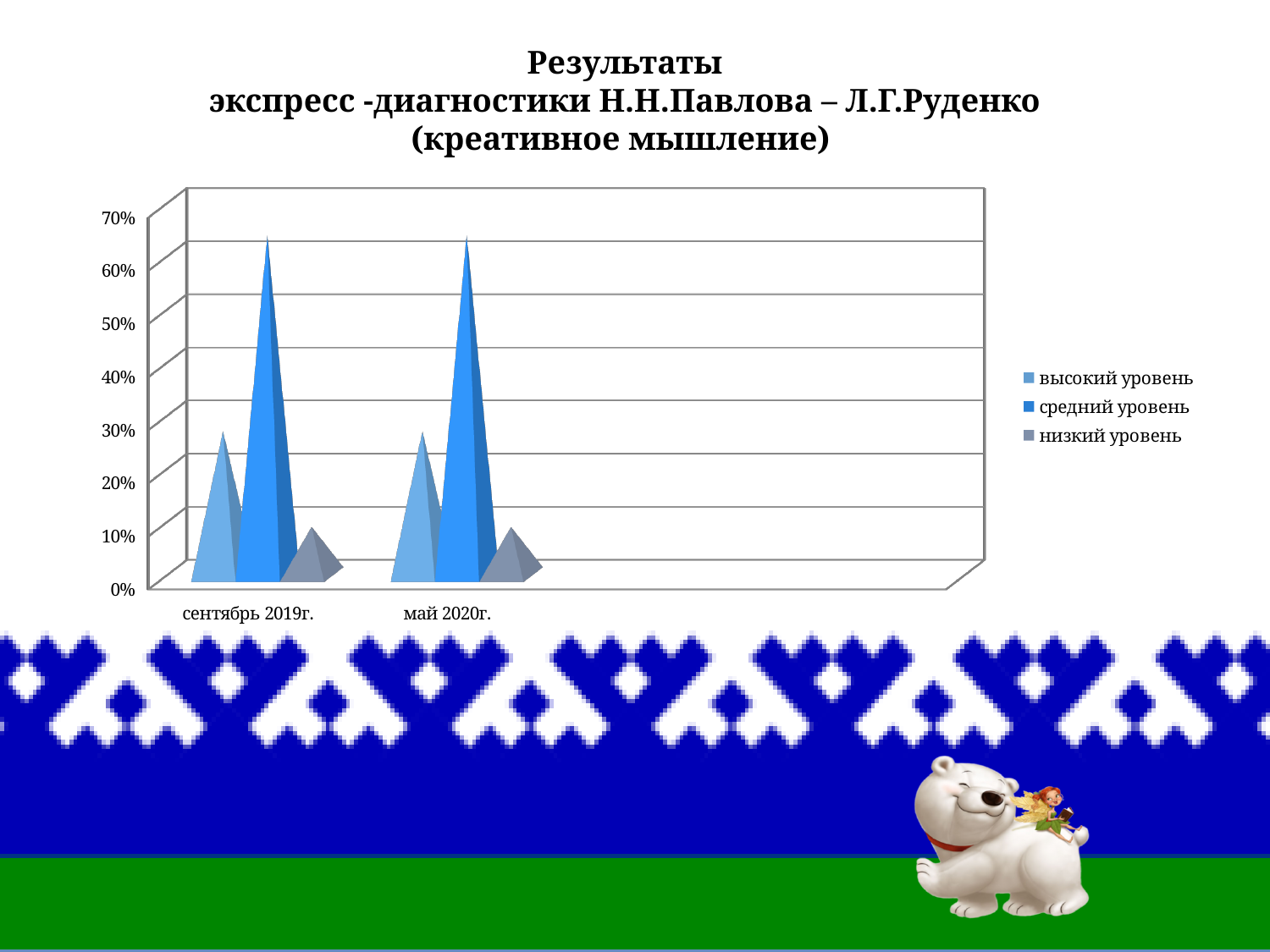
Which series has the highest value for сентябрь 2019г.? средний уровень Is the value for низкий уровень in май 2020г. greater or less than 20%? less What kind of chart is shown on the slide? bar chart Is the value for высокий уровень in сентябрь 2019г. greater or less than 40%? less Is the value for средний уровень in май 2020г. greater or less than 70%? less Which series has the lowest value for май 2020г.? низкий уровень How many series does the legend list? 3 Which series has the highest value for май 2020г.? средний уровень How many categories are shown on the x axis? 2 For май 2020г., which is larger: высокий уровень or средний уровень? средний уровень What are the two categories on the x axis? сентябрь 2019г. and май 2020г.